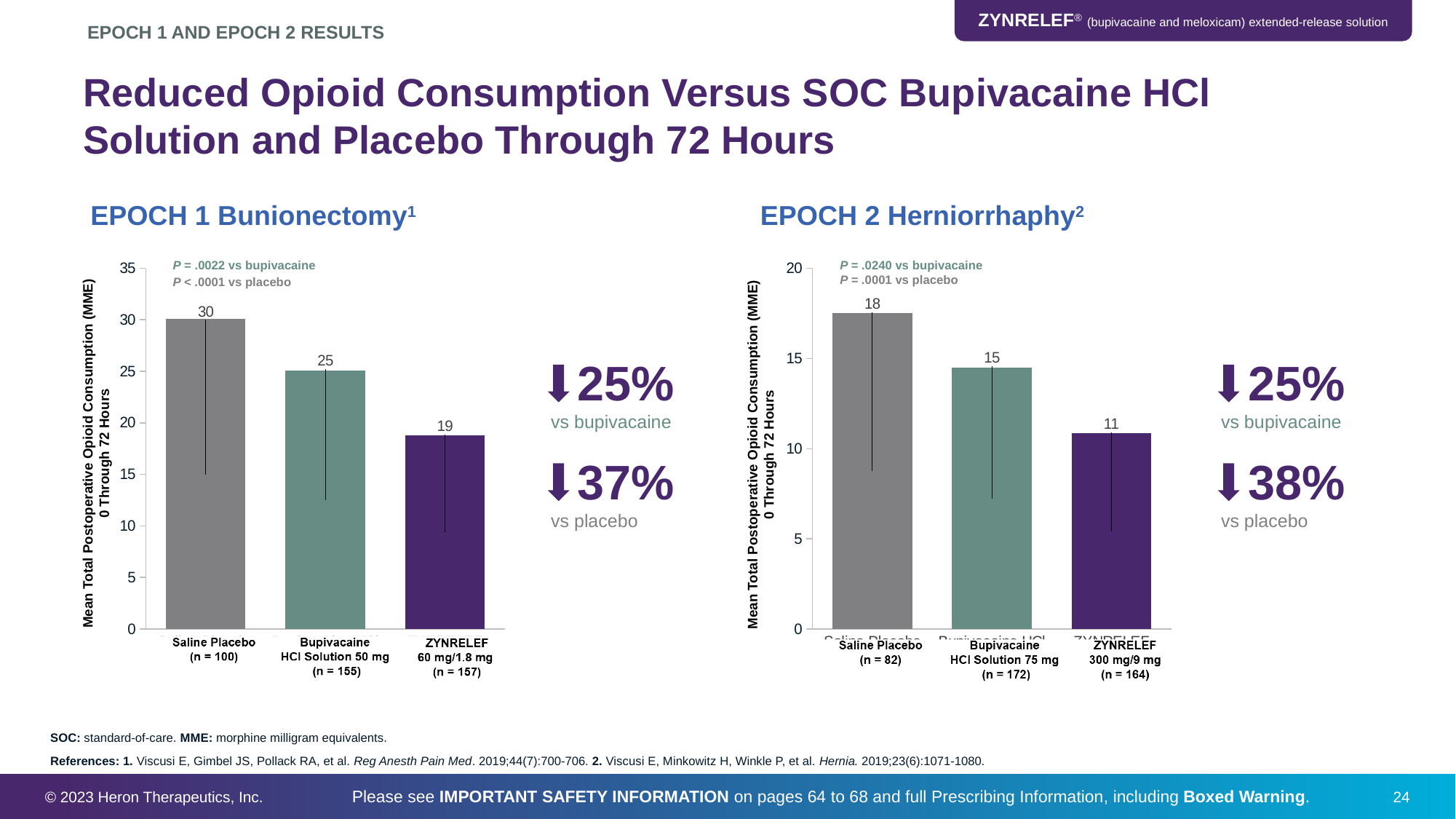
In the EPOCH 1 Bunionectomy chart, what is the mean total postoperative opioid consumption for Saline Placebo? 30 In the EPOCH 1 Bunionectomy chart, what is the difference between the Saline Placebo value and the ZYNRELEF value? 11 In the EPOCH 2 Herniorrhaphy chart, what is the value for Bupivacaine HCl Solution 75 mg? 15 In the EPOCH 2 Herniorrhaphy chart, which group has the lowest mean opioid consumption? ZYNRELEF 300 mg/9 mg What type of chart is the EPOCH 2 Herniorrhaphy chart? Bar chart In the EPOCH 2 Herniorrhaphy chart, which is larger: the value for Saline Placebo or the value for ZYNRELEF 300 mg/9 mg? Saline Placebo In the EPOCH 1 Bunionectomy chart, do the values rise or fall from left to right across the groups? Fall In the EPOCH 2 Herniorrhaphy chart, what is the difference between the Saline Placebo value and the Bupivacaine HCl Solution 75 mg value? 3 In the EPOCH 1 Bunionectomy chart, what is the value for ZYNRELEF 60 mg/1.8 mg? 19 How many bars are in the EPOCH 1 Bunionectomy chart? 3 In the EPOCH 2 Herniorrhaphy chart, what is the value for ZYNRELEF 300 mg/9 mg? 11 In the EPOCH 1 Bunionectomy chart, which group has the highest mean opioid consumption? Saline Placebo